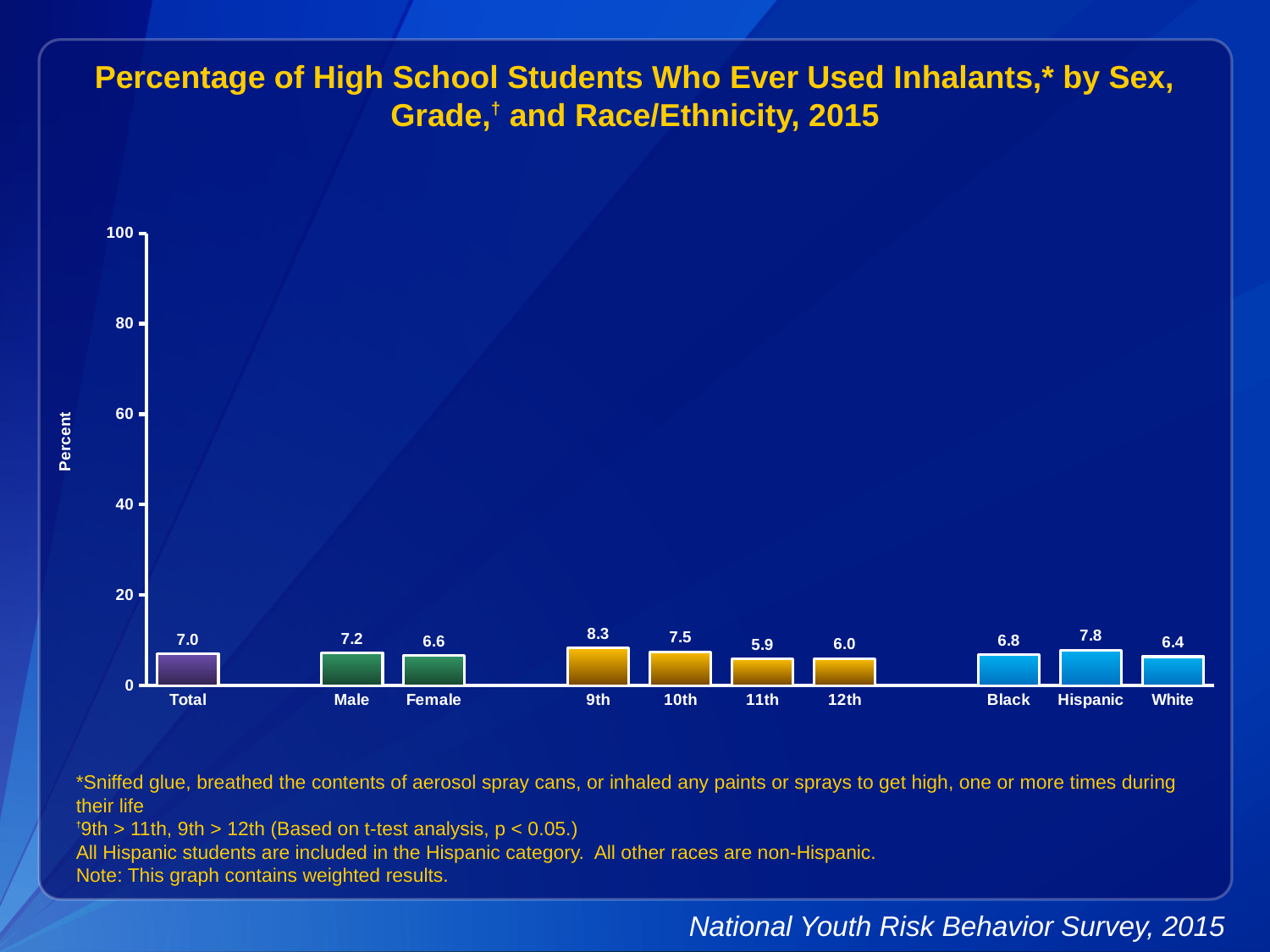
How many categories are shown on the x axis? 10 What is the value for Total? 7.0 What is the difference between the 9th and 12th grade values? 2.3 What percentage of 9th grade students ever used inhalants? 8.3 What is the difference between the Male and Female values? 0.6 What is the value for Hispanic students? 7.8 What kind of chart is this? bar chart Which is larger, the value for Black or the value for White? Black What is the label on the y axis? Percent Is the value for 10th grade greater or less than 20? less Which category has the lowest value? 11th Which category has the highest value? 9th